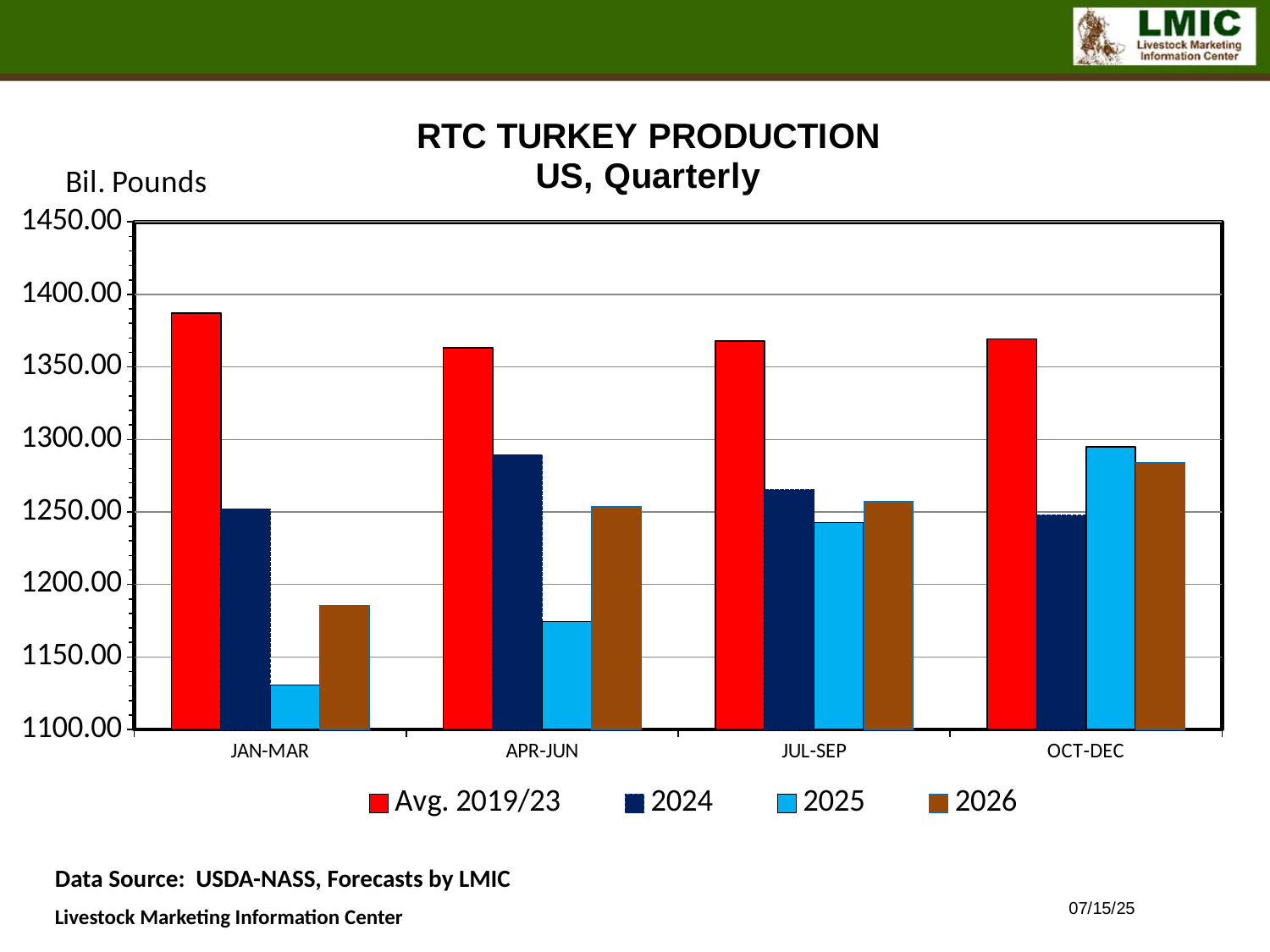
In OCT-DEC, which is larger: the 2024 value or the 2025 value? 2025 In which quarter is the 2024 value highest? APR-JUN In which quarter is the 2025 value lowest? JAN-MAR In which quarter is the 2025 value highest? OCT-DEC Do the 2025 values rise or fall from JAN-MAR to OCT-DEC? rise Is the value for 2025 in JAN-MAR greater or less than 1150? less How many quarters are shown on the x axis? 4 In JAN-MAR, which is larger: the 2024 value or the 2026 value? 2024 How many series does the legend list? 4 Is the value for 2026 in JAN-MAR greater or less than 1200? less What kind of chart is shown on the slide? bar chart Is the value for Avg. 2019/23 in JAN-MAR greater or less than 1350? greater